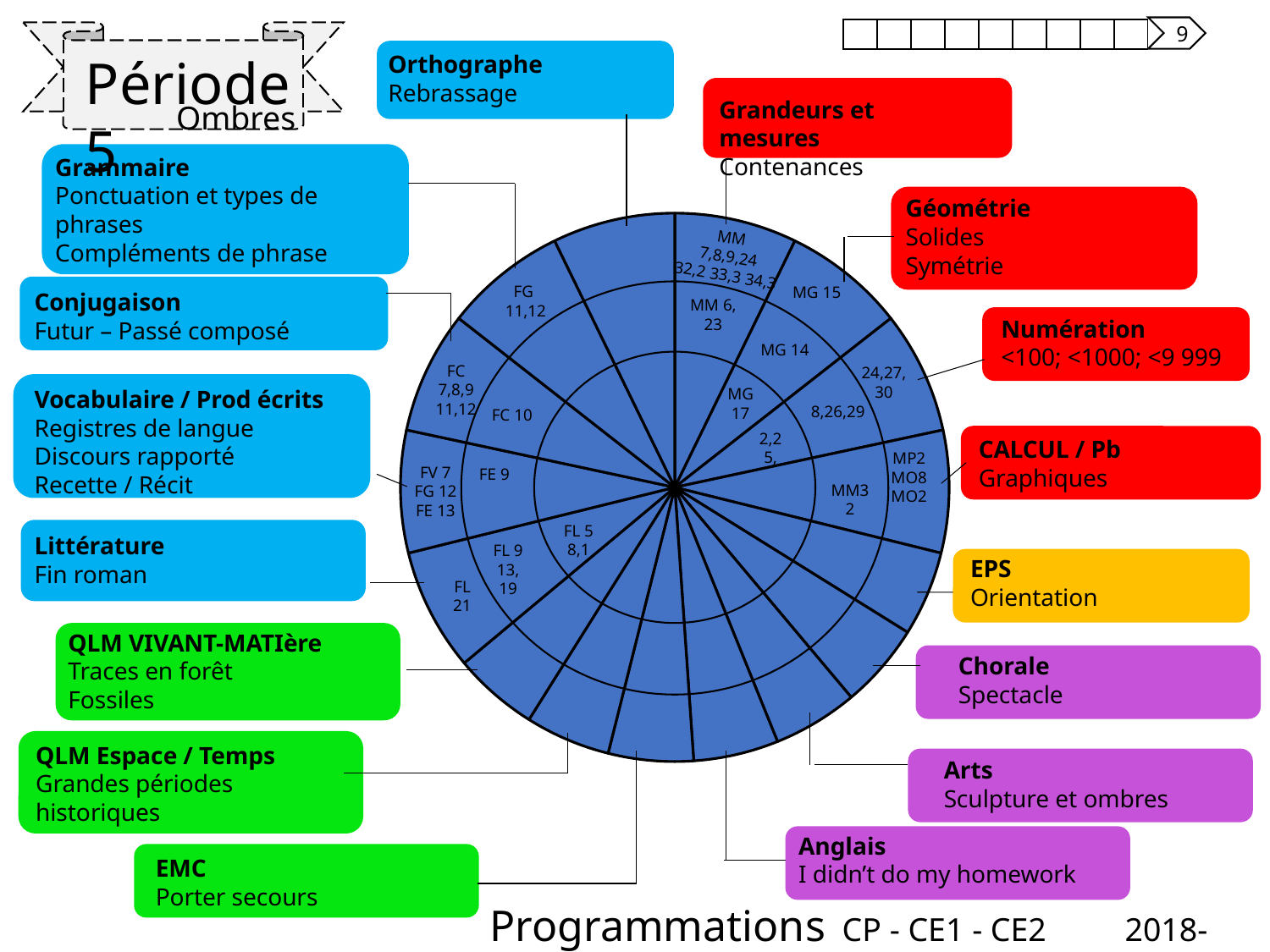
What colour are the sectors of the circular wheel diagram? Blue What label is printed in the outer sector of the wheel that is connected to the Littérature box? FL 21 What label is printed in the outer sector of the wheel that is connected to the Numération box? 24,27, 30 What is the title printed at the bottom of the slide beneath the wheel? Programmations What label is printed in the outer sector of the wheel that is connected to the Géométrie box? MG 15 What label is printed in the outer sector of the wheel that is connected to the Conjugaison box? FC 7,8,9 11,12 What label is printed in the innermost ring of the wheel below the MG 14 sector? MG 17